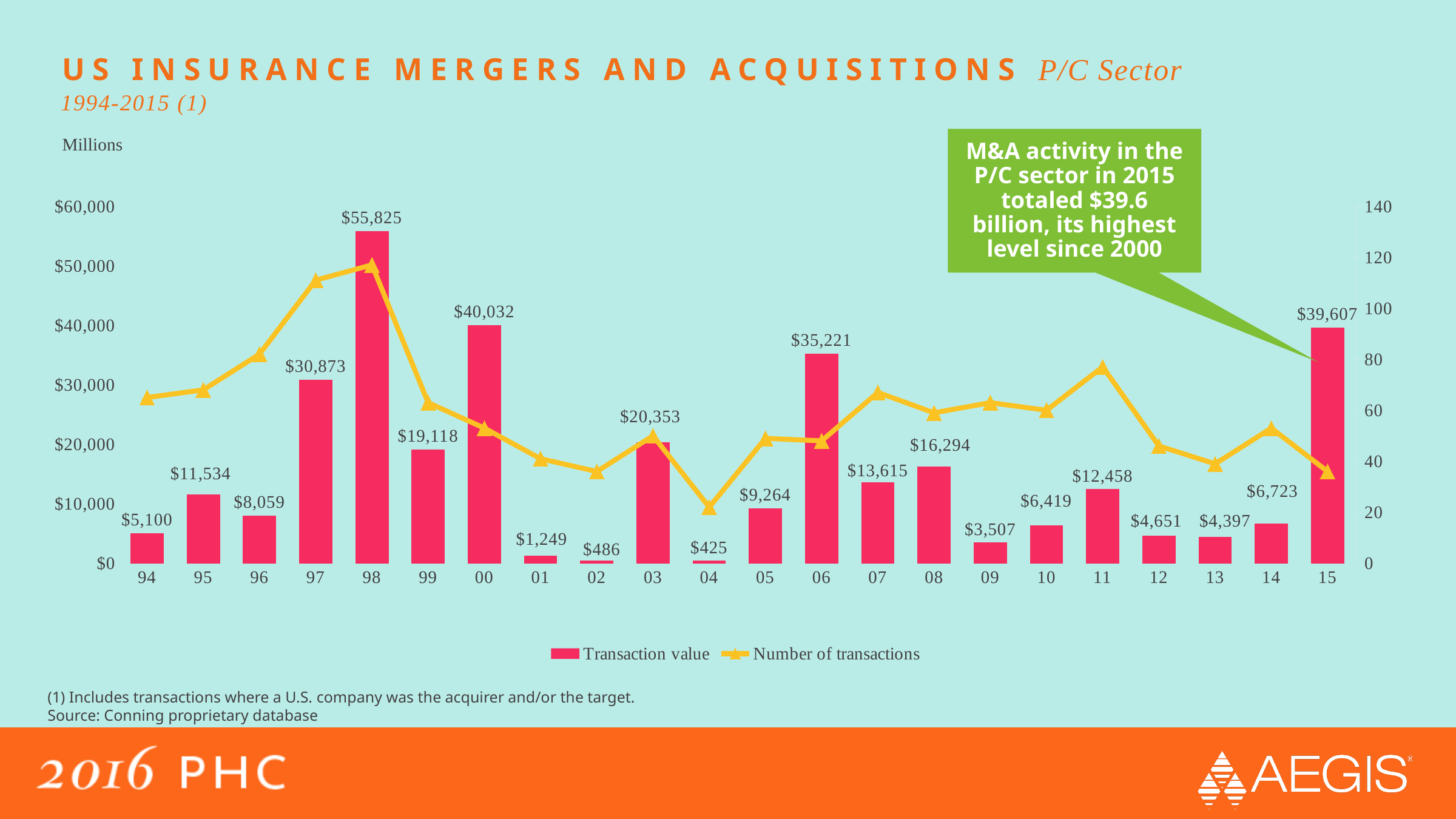
Which year has the lowest transaction value? 04 Is the number of transactions in 98 greater or less than 100? greater What is the transaction value for 98? $55,825 What is the difference between the transaction values for 98 and 00? $15,793 Is the number of transactions in 04 greater or less than 40? less How many years are shown on the x axis? 22 How many series does the legend list? 2 Which year has the highest transaction value? 98 Which has the larger transaction value, 00 or 06? 00 Does the number of transactions rise or fall from 94 to 98? rise What is the transaction value for 15? $39,607 What is the transaction value for 04? $425